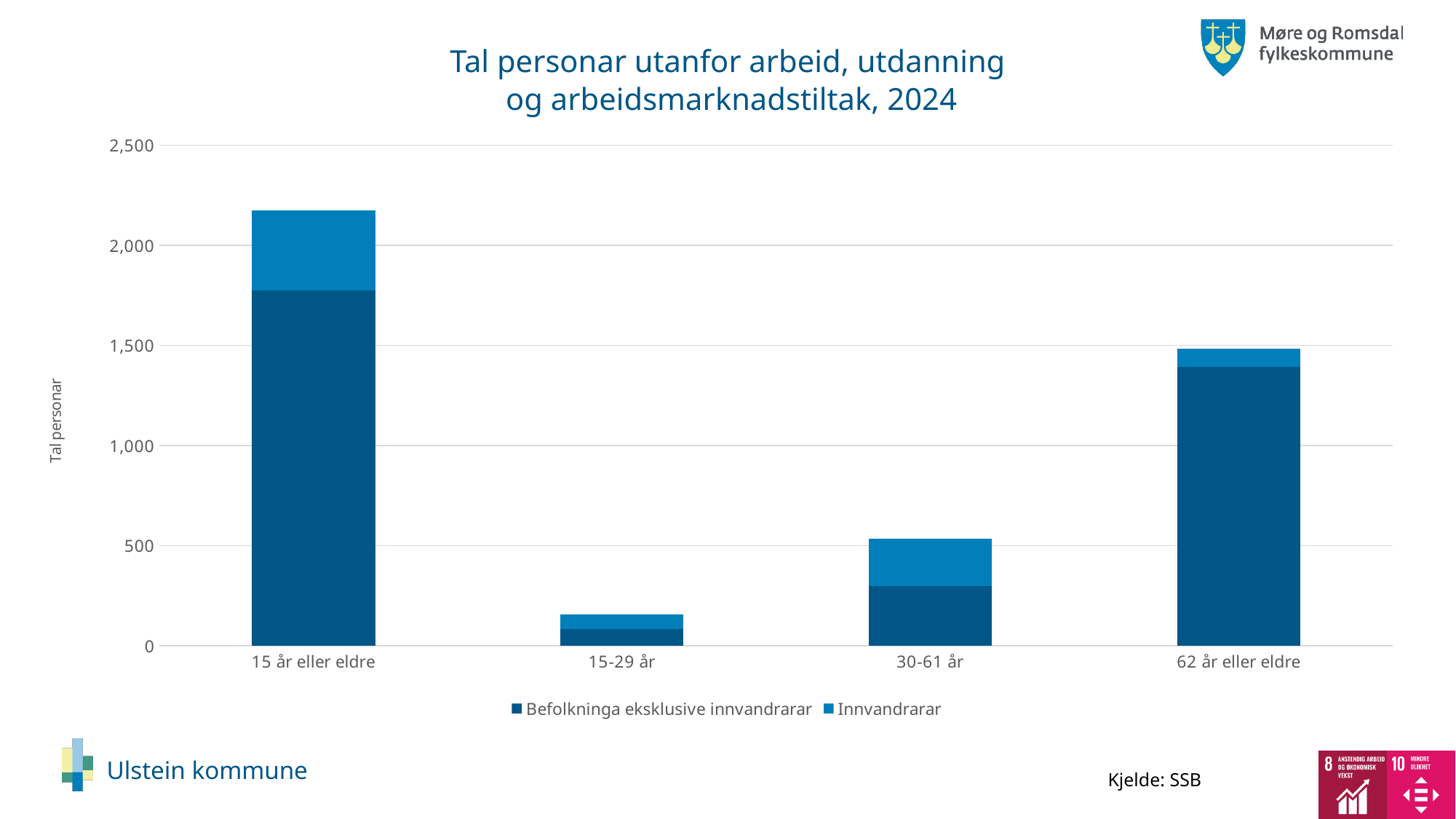
Is the total stacked bar for 15 år eller eldre greater or less than 2,000? greater What kind of chart is shown on the slide? Stacked bar chart Which stacked bar is taller: 30-61 år or 15-29 år? 30-61 år Is the Befolkninga eksklusive innvandrarar value for 30-61 år greater or less than 500? less How many series does the legend list? 2 Which category has the shortest stacked bar? 15-29 år Is the total stacked bar for 15-29 år greater or less than 500? less How many age categories are shown on the x axis? 4 Which category has the tallest stacked bar? 15 år eller eldre What is the label of the y axis? Tal personar Which stacked bar is taller: 62 år eller eldre or 30-61 år? 62 år eller eldre